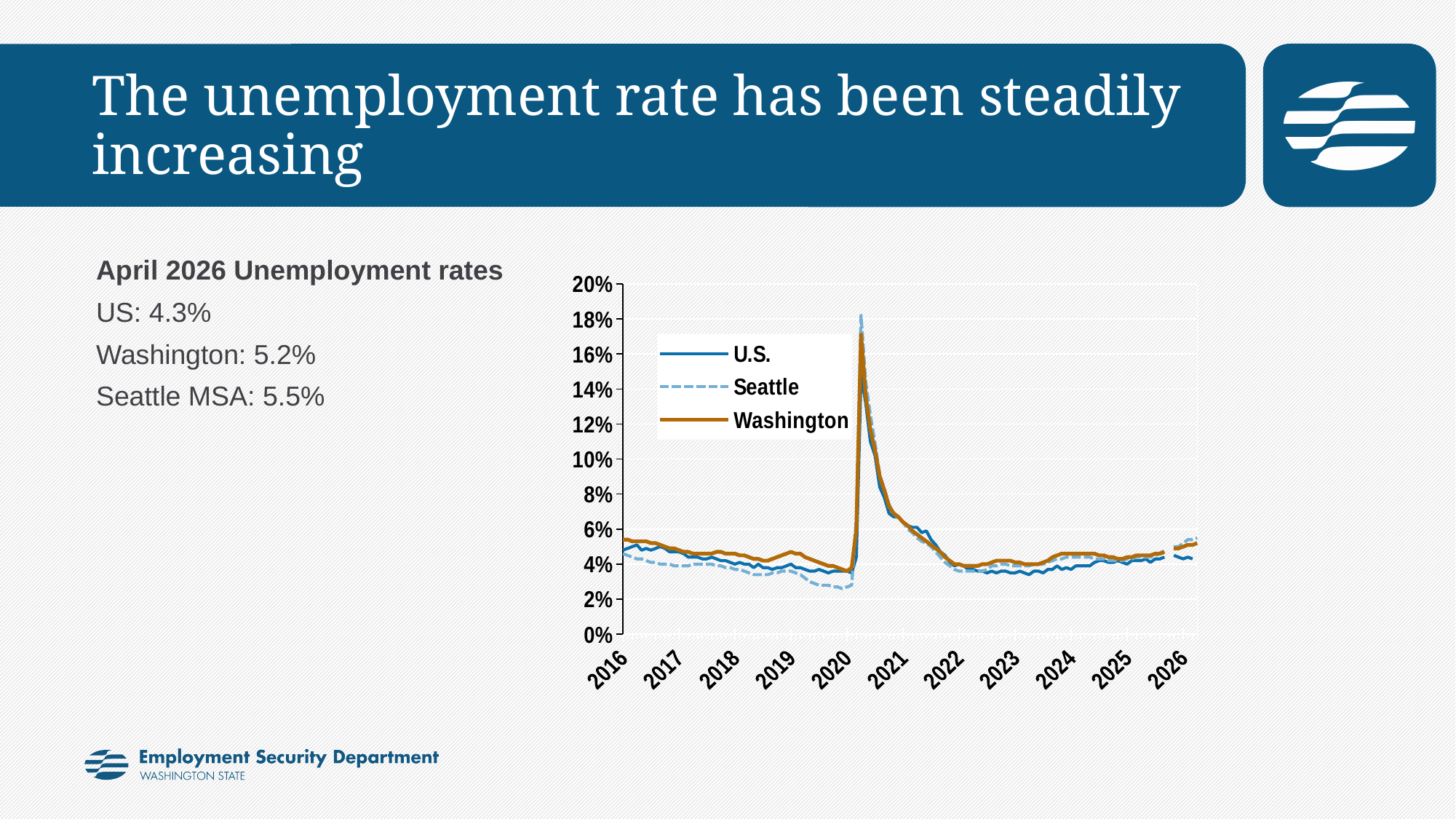
In April 2026, which was higher: the Washington unemployment rate or the U.S. unemployment rate? Washington What are the three series named in the chart's legend? U.S., Seattle, Washington Just before the 2020 spike, is the Seattle line greater or less than 4%? less Is the peak value of the Seattle line in 2020 greater or less than 16%? greater Which series has the lowest peak during the 2020 spike? U.S. Is the value of the Washington line at the start of 2016 greater or less than 4%? greater How many series does the chart's legend list? 3 According to the slide, what was the Seattle MSA unemployment rate in April 2026? 5.5% According to the slide, what was the U.S. unemployment rate in April 2026? 4.3% What kind of chart is shown on the slide? Line chart How many year labels are shown along the chart's x axis? 11 What is the highest value shown on the chart's vertical axis? 20%